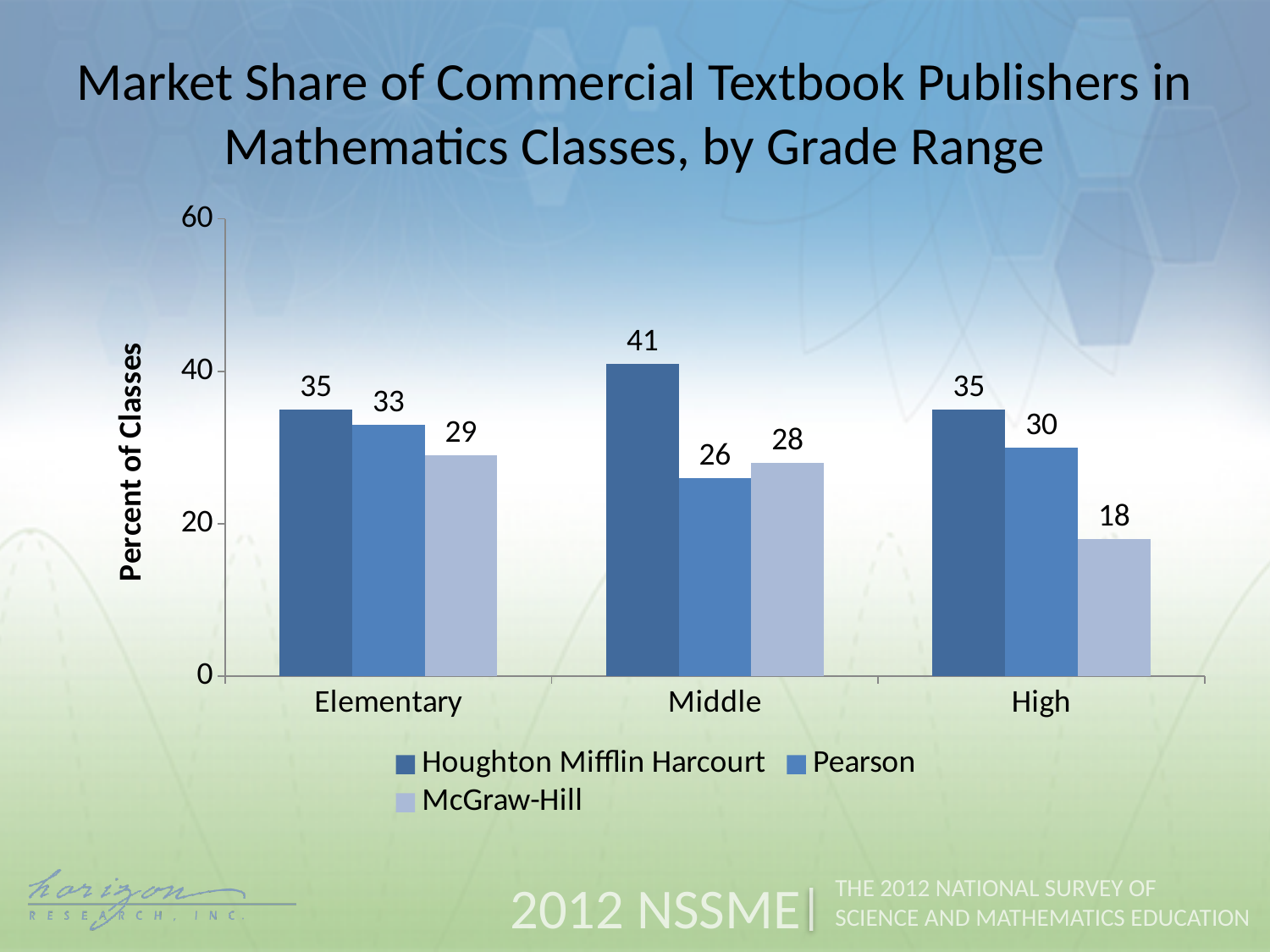
What is the label of the y axis? Percent of Classes How many grade ranges are shown on the x axis? 3 What is the value for Pearson in Elementary grades? 33 What kind of chart is shown on the slide? Bar chart What is the difference between Houghton Mifflin Harcourt and Pearson in Middle grades? 15 How many series does the legend list? 3 Which grade range has the highest value for Houghton Mifflin Harcourt? Middle What is the value for McGraw-Hill in High grades? 18 Which grade range has the lowest value for McGraw-Hill? High Is the value for Houghton Mifflin Harcourt in Middle grades greater or less than 40? greater What is the value for Houghton Mifflin Harcourt in Middle grades? 41 Which is larger in Middle grades: Pearson or McGraw-Hill? McGraw-Hill